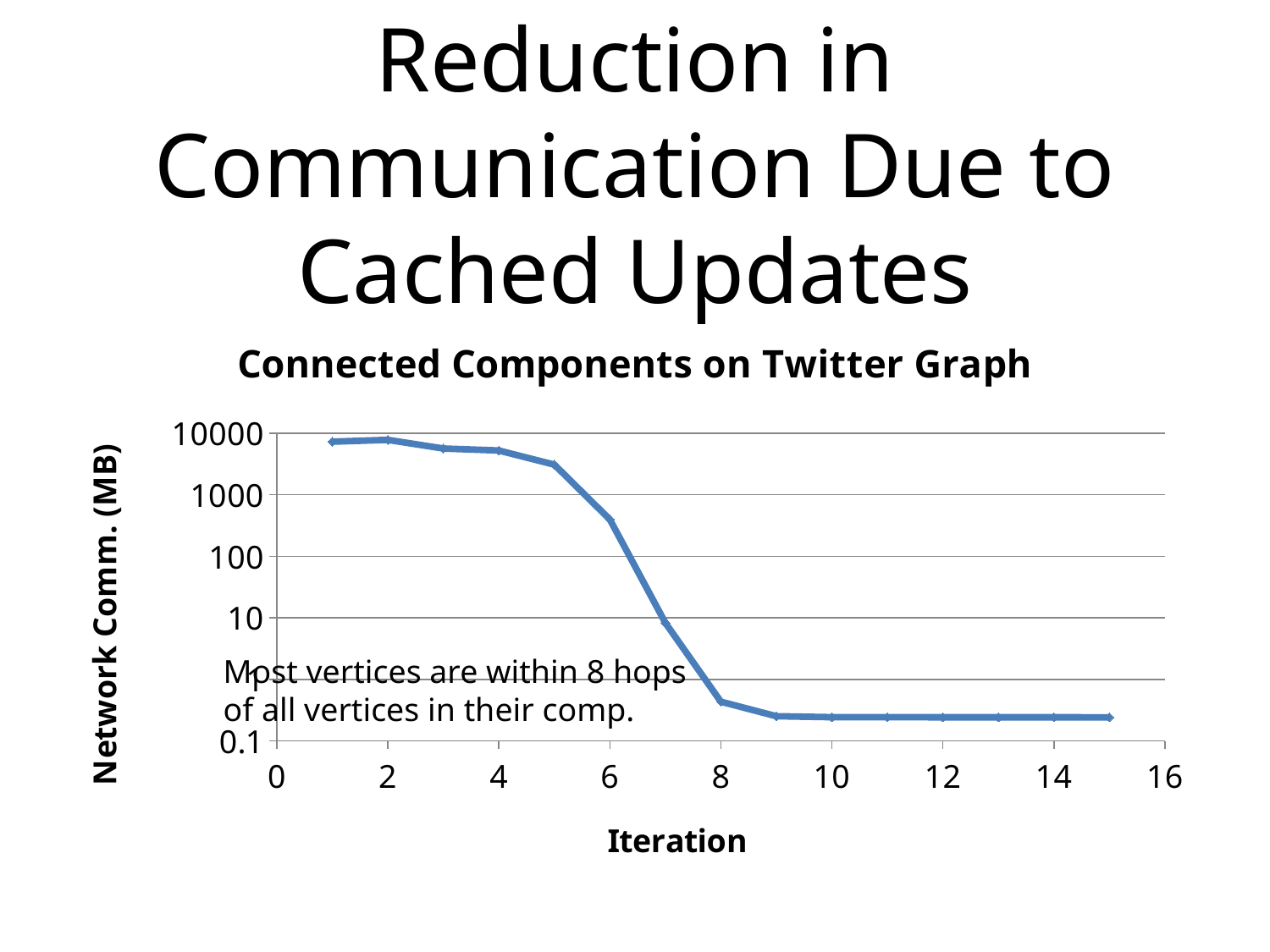
Do the values generally rise or fall as the iteration increases? fall What kind of chart is shown on the slide? line chart Is the value at iteration 5 greater or less than 1000? greater What is the label of the y axis? Network Comm. (MB) Which has the larger value, iteration 6 or iteration 10? iteration 6 What is the title of the chart? Connected Components on Twitter Graph Is the value at iteration 6 greater or less than 100? greater Is the value at iteration 12 greater or less than 1? less How many data points are plotted on the line? 15 Which has the larger value, iteration 1 or iteration 8? iteration 1